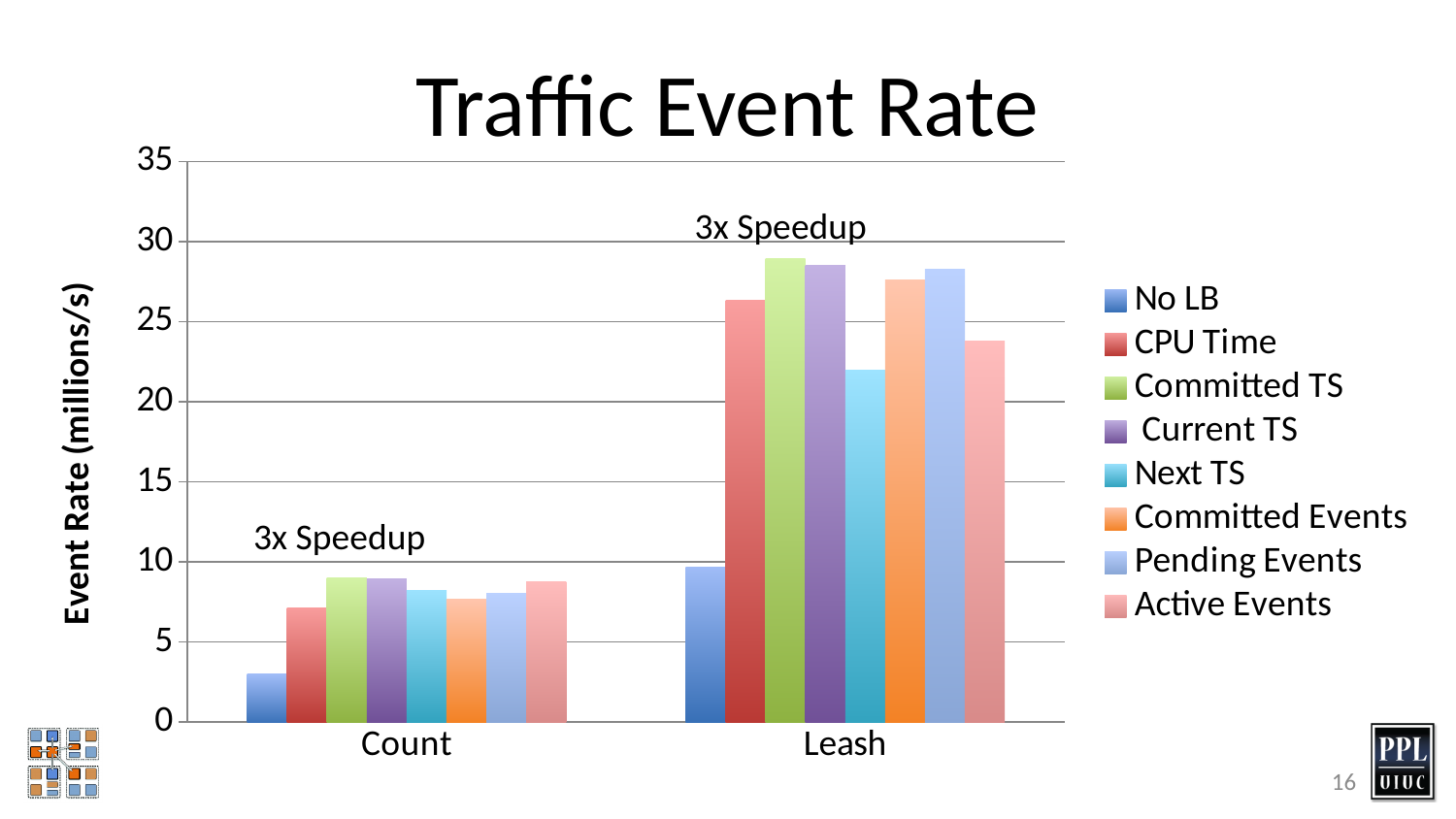
Is the value for No LB in the Leash category greater or less than 10? less Is the value for Committed TS in the Leash category greater or less than 25? greater What is the label of the y axis? Event Rate (millions/s) What kind of chart is shown on the slide? bar chart How many series does the legend list? 8 Which is larger: No LB for Count or No LB for Leash? Leash Is the value for Next TS in the Leash category greater or less than 20? greater How many categories are shown on the x axis? 2 Which series has the lowest value in the Leash category? No LB In the Leash category, which is larger: CPU Time or Next TS? CPU Time Which series has the lowest value in the Count category? No LB